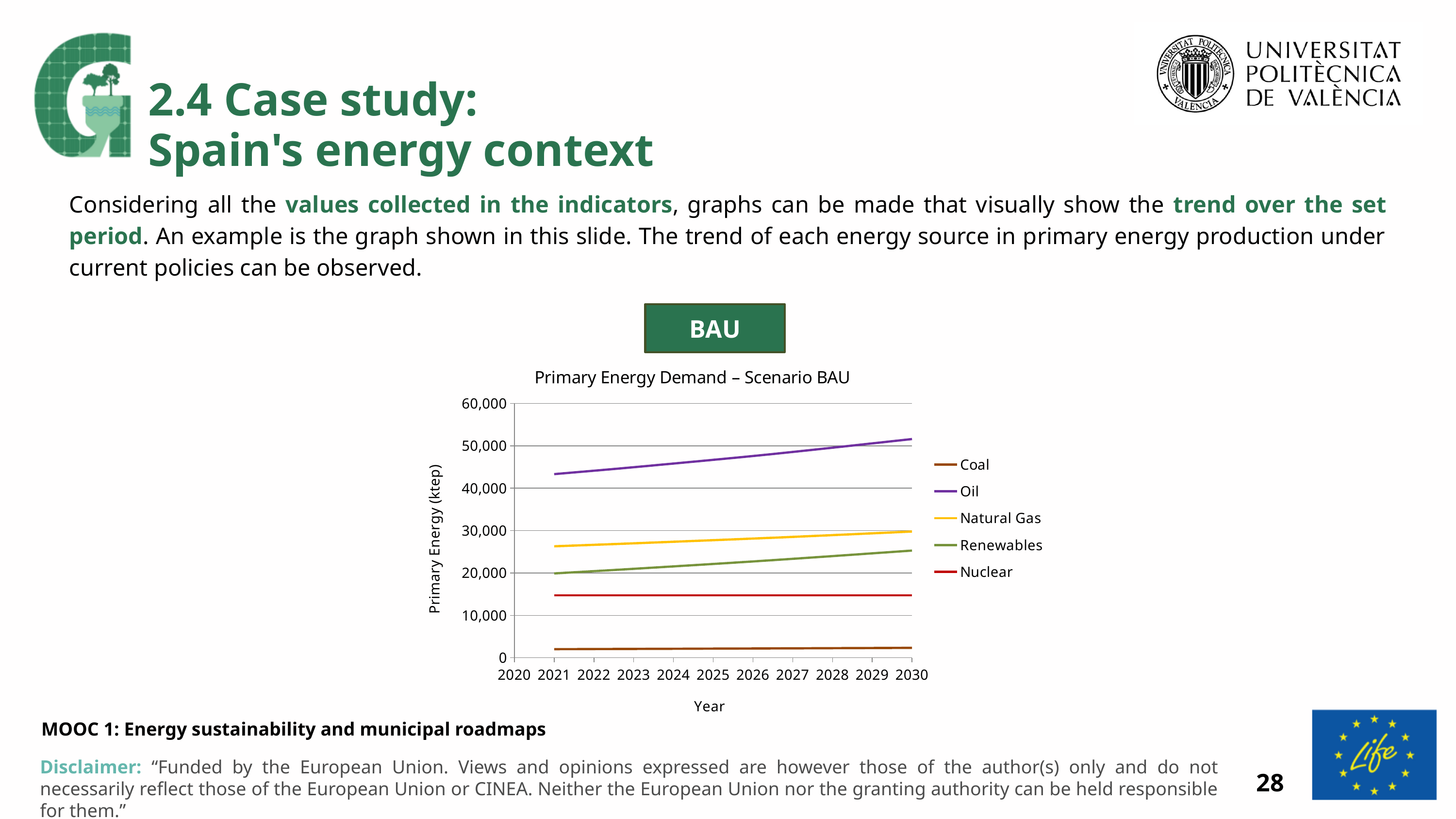
What kind of chart is shown on the slide? line chart Is the value for Renewables in 2021 greater or less than 30,000? less Is the value for Oil in 2021 greater or less than 40,000? greater Is the value for Nuclear in 2025 greater or less than 20,000? less How many series does the legend of the chart list? 5 Which energy source has the highest primary energy demand throughout the period shown? Oil Does the Oil line rise or fall from 2021 to 2030? rises In 2021, which is larger: the value for Natural Gas or the value for Renewables? Natural Gas Which energy source has the lowest primary energy demand throughout the period shown? Coal Does the Renewables line rise or fall from 2021 to 2030? rises What is the title of the chart? Primary Energy Demand – Scenario BAU